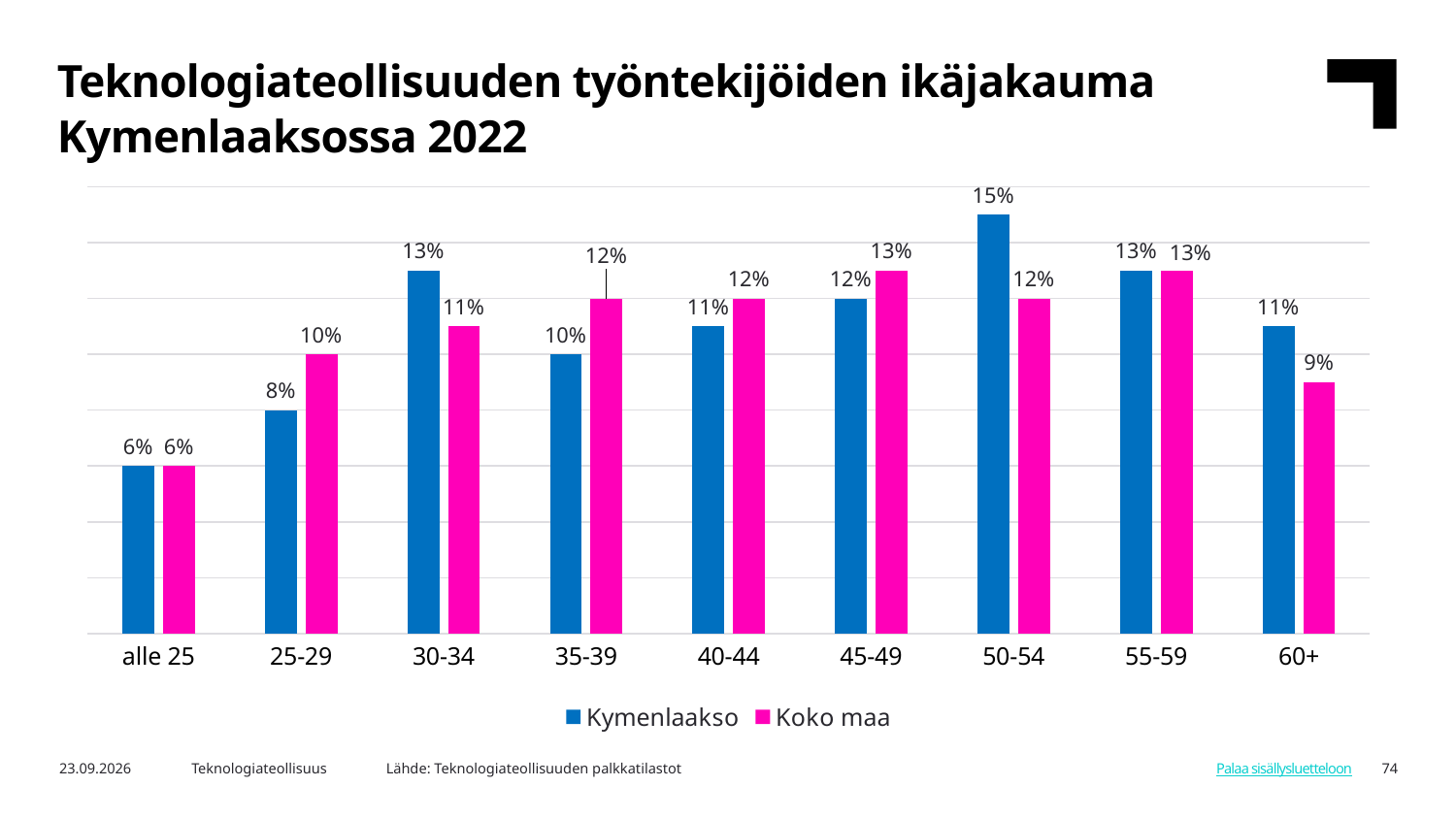
Which is larger for the 30-34 age group, the Kymenlaakso value or the Koko maa value? Kymenlaakso What is the Kymenlaakso value for the 60+ age group? 11% Which is larger for the 35-39 age group, the Kymenlaakso value or the Koko maa value? Koko maa How many series does the legend list? 2 What kind of chart is shown on the slide? Bar chart What is the Koko maa value for the 25-29 age group? 10% What is the difference between the Kymenlaakso and Koko maa values for the 50-54 age group? 3% How many age groups are shown on the x axis? 9 Which age group has the lowest Koko maa value? alle 25 Which age group has the highest Kymenlaakso value? 50-54 Which series is shown in pink in the legend? Koko maa What is the Kymenlaakso value for the 50-54 age group? 15%